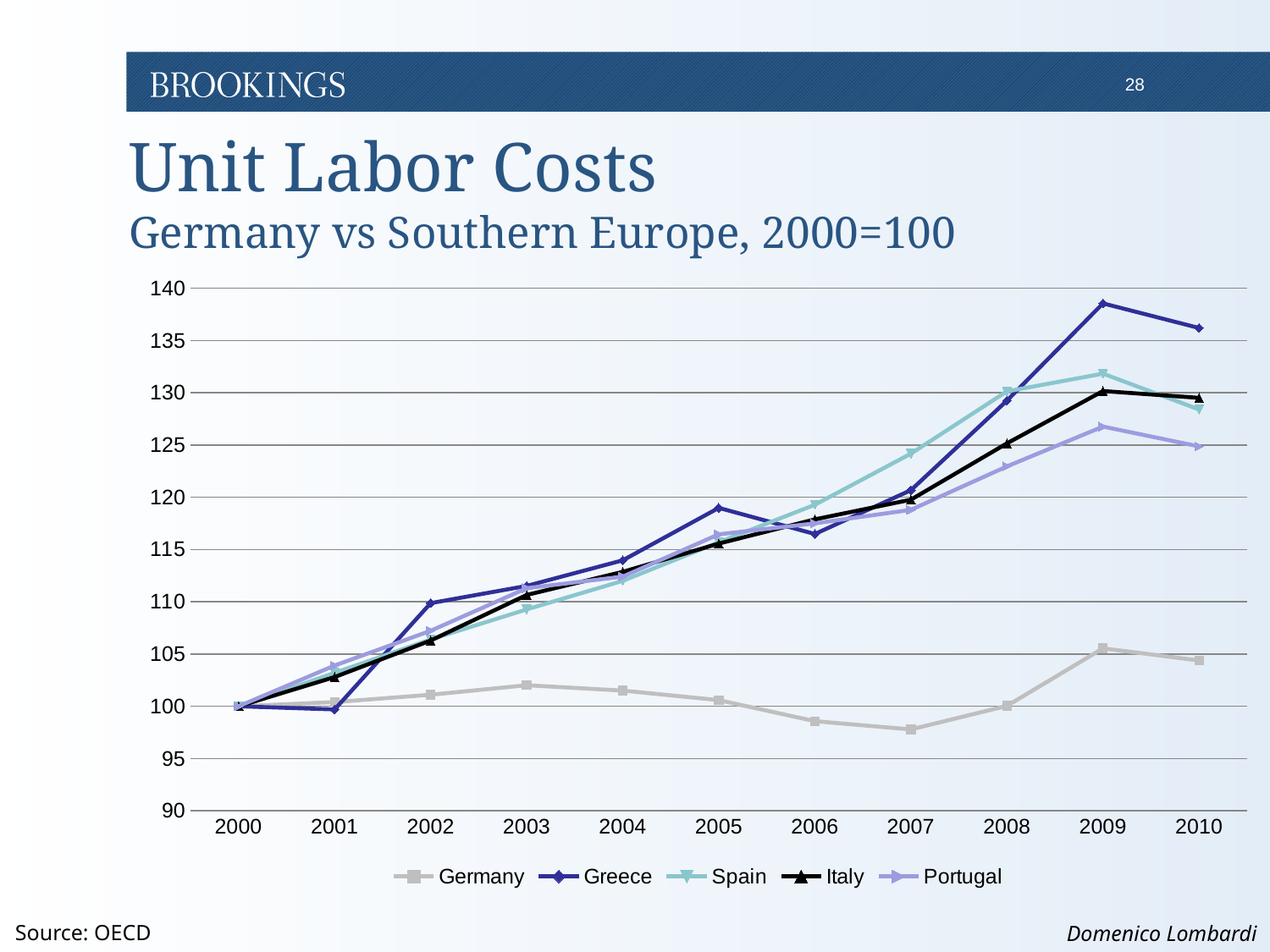
How many series does the legend list? 5 Which is larger in 2010, the value for Greece or the value for Germany? Greece How many years are plotted along the x axis? 11 Does the Italy line rise or fall from 2000 to 2009? rise Is the value for Germany in 2007 greater or less than 100? less Is the value for Portugal in 2010 greater or less than 130? less Which country has the highest unit labor cost index in 2009? Greece What is the subtitle of the chart? Germany vs Southern Europe, 2000=100 What is the value for Germany in 2000? 100 Which country has the lowest unit labor cost index in 2010? Germany Is the value for Greece in 2009 greater or less than 135? greater What kind of chart is shown on the slide? line chart